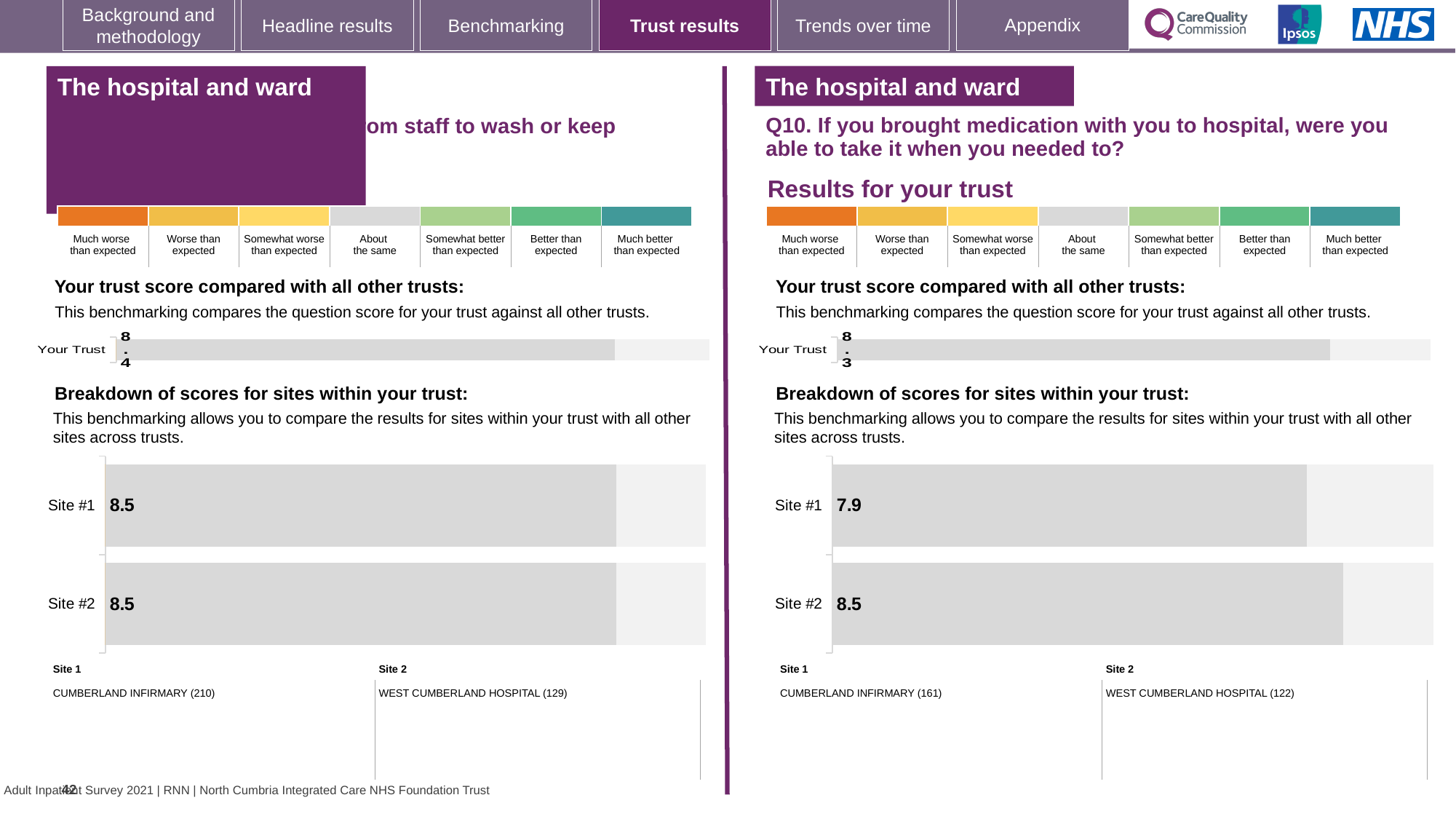
How many sites are shown on the left-hand site breakdown chart? 2 What kind of chart is the right-hand 'Breakdown of scores for sites within your trust' chart? Bar chart On the right-hand site breakdown chart (Q10), what is the difference between the Site #2 and Site #1 scores? 0.6 On the left-hand 'Your trust score compared with all other trusts' chart, what is the score for Your Trust? 8.4 On the right-hand 'Your trust score compared with all other trusts' chart (Q10), what is the score for Your Trust? 8.3 On the left-hand 'Breakdown of scores for sites within your trust' chart, what is the score for Site #1? 8.5 On the left-hand 'Breakdown of scores for sites within your trust' chart, what is the score for Site #2? 8.5 Which 'Your Trust' score is higher: the one on the left-hand chart or the one on the right-hand (Q10) chart? The left-hand chart (8.4) On the right-hand site breakdown chart (Q10), which site has the lowest score? Site #1 On the right-hand 'Breakdown of scores for sites within your trust' chart (Q10), what is the score for Site #1? 7.9 On the right-hand 'Breakdown of scores for sites within your trust' chart (Q10), what is the score for Site #2? 8.5 On the right-hand site breakdown chart (Q10), which site has the higher score, Site #1 or Site #2? Site #2